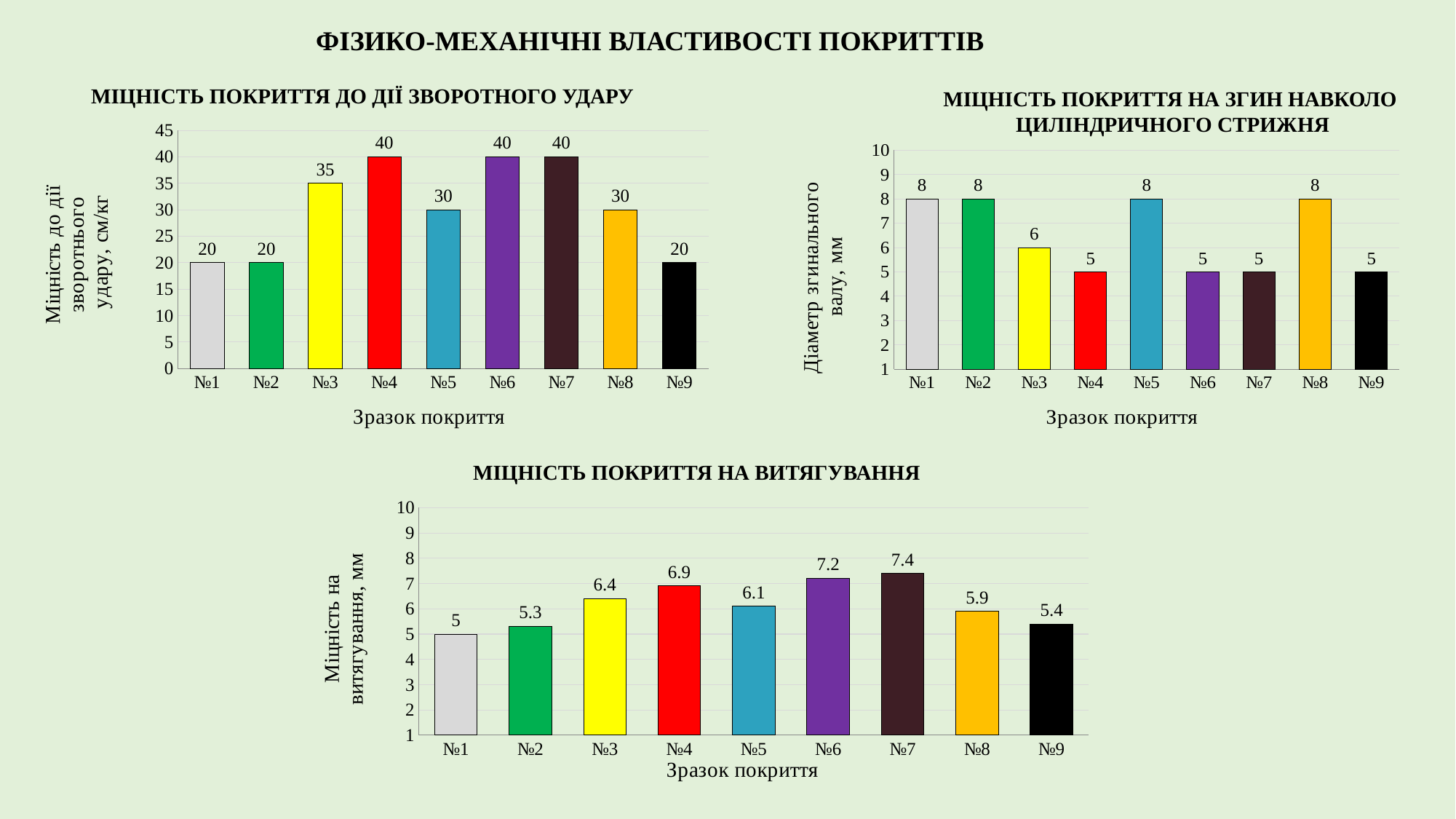
In the bottom chart (МІЦНІСТЬ ПОКРИТТЯ НА ВИТЯГУВАННЯ), what is the difference between the values for №6 and №2? 1.9 In the top-right chart (МІЦНІСТЬ ПОКРИТТЯ НА ЗГИН НАВКОЛО ЦИЛІНДРИЧНОГО СТРИЖНЯ), what is the value for sample №3? 6 In the bottom chart (МІЦНІСТЬ ПОКРИТТЯ НА ВИТЯГУВАННЯ), which sample has the highest value? №7 In the top-right chart (МІЦНІСТЬ ПОКРИТТЯ НА ЗГИН НАВКОЛО ЦИЛІНДРИЧНОГО СТРИЖНЯ), what is the difference between the values for №1 and №4? 3 In the top-right chart (МІЦНІСТЬ ПОКРИТТЯ НА ЗГИН НАВКОЛО ЦИЛІНДРИЧНОГО СТРИЖНЯ), what is the value for sample №7? 5 In the top-left chart (МІЦНІСТЬ ПОКРИТТЯ ДО ДІЇ ЗВОРОТНОГО УДАРУ), what is the difference between the values for №4 and №1? 20 In the top-left chart (МІЦНІСТЬ ПОКРИТТЯ ДО ДІЇ ЗВОРОТНОГО УДАРУ), which is larger, the value for №5 or №3? №3 In the bottom chart (МІЦНІСТЬ ПОКРИТТЯ НА ВИТЯГУВАННЯ), which sample has the lowest value? №1 In the top-left chart (МІЦНІСТЬ ПОКРИТТЯ ДО ДІЇ ЗВОРОТНОГО УДАРУ), what is the value for sample №3? 35 What kind of chart is the bottom chart (МІЦНІСТЬ ПОКРИТТЯ НА ВИТЯГУВАННЯ)? Bar chart In the bottom chart (МІЦНІСТЬ ПОКРИТТЯ НА ВИТЯГУВАННЯ), what is the value for sample №4? 6.9 In the top-left chart (МІЦНІСТЬ ПОКРИТТЯ ДО ДІЇ ЗВОРОТНОГО УДАРУ), how many samples are plotted? 9